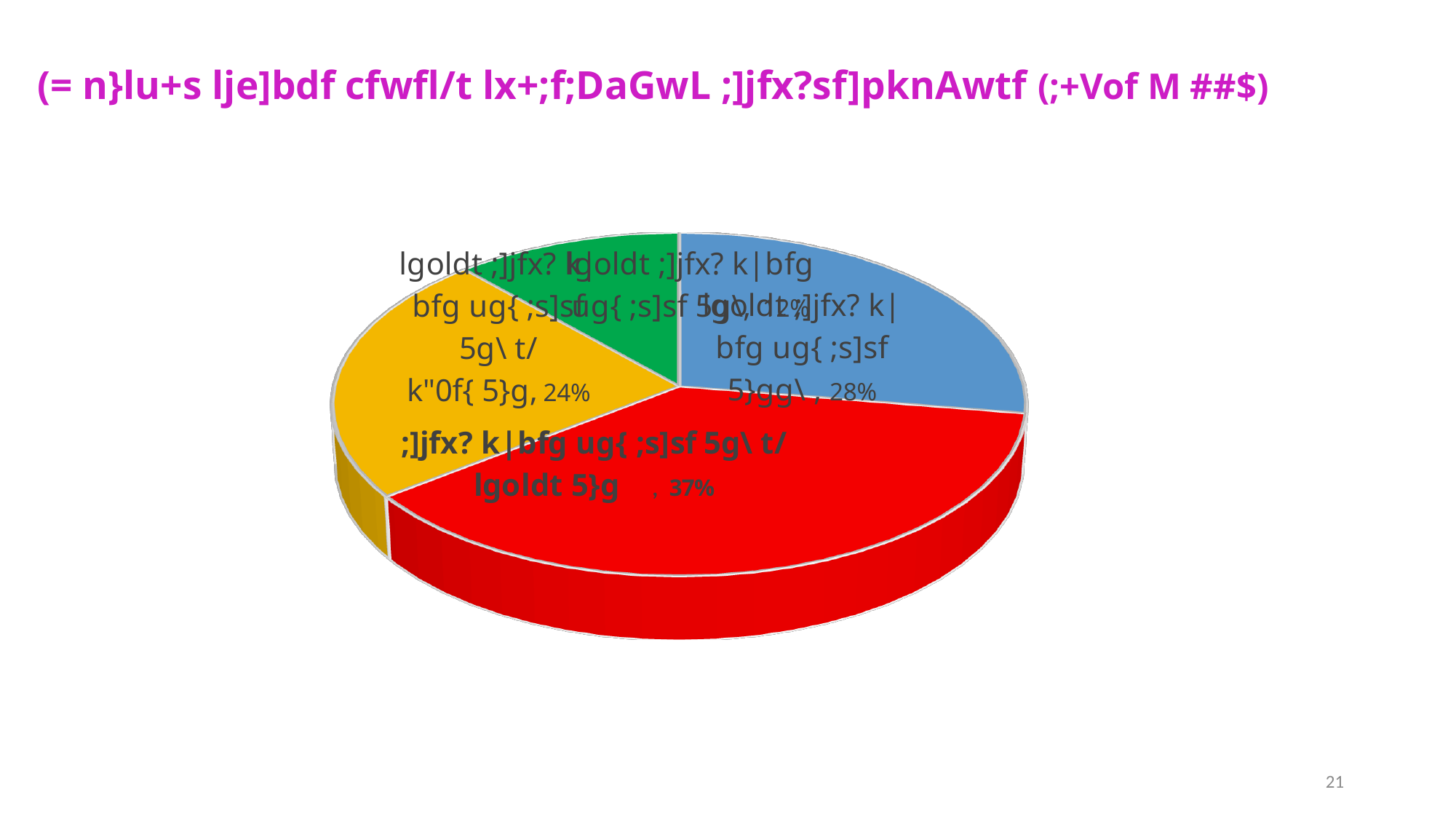
What percentage is shown for the red slice of the pie chart? 37% Which colour slice is the largest in the pie chart? red Which colour slice is the smallest in the pie chart? green What share of the pie does the red slice represent? 37% What percentage is shown for the yellow slice of the pie chart? 24% Which is larger, the red slice or the blue slice? red What is the difference in percentage points between the red slice and the blue slice? 9% What kind of chart is shown on the slide? pie chart What is the difference in percentage points between the blue slice and the yellow slice? 4% What percentage is shown for the blue slice of the pie chart? 28% Which is larger, the blue slice or the yellow slice? blue How many slices does the pie chart have? 4